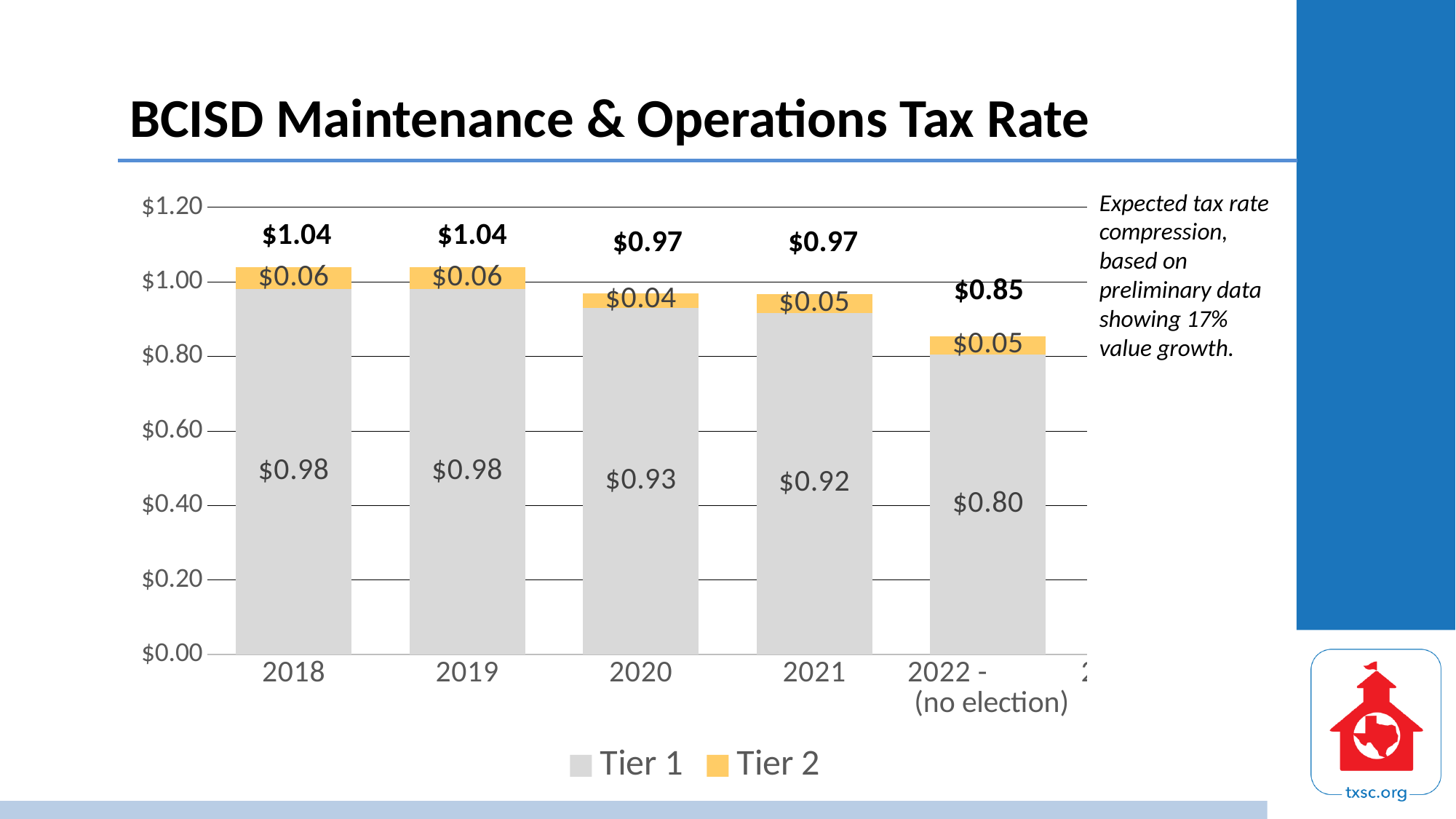
What is the total tax rate shown for 2021? $0.97 Which year has the lowest Tier 1 value? 2022 (no election) What is the total tax rate shown for 2022 (no election)? $0.85 What is the Tier 2 value for 2021? $0.05 Is the Tier 1 value for 2021 larger or smaller than the Tier 1 value for 2020? smaller What is the difference between the Tier 1 values for 2019 and 2021? $0.06 What is the Tier 2 value for 2018? $0.06 How many series does the legend list? 2 Which year has the lowest Tier 2 value? 2020 What kind of chart is shown on the slide? Stacked bar chart What is the Tier 1 value for 2020? $0.93 What is the Tier 1 value for 2022 (no election)? $0.80